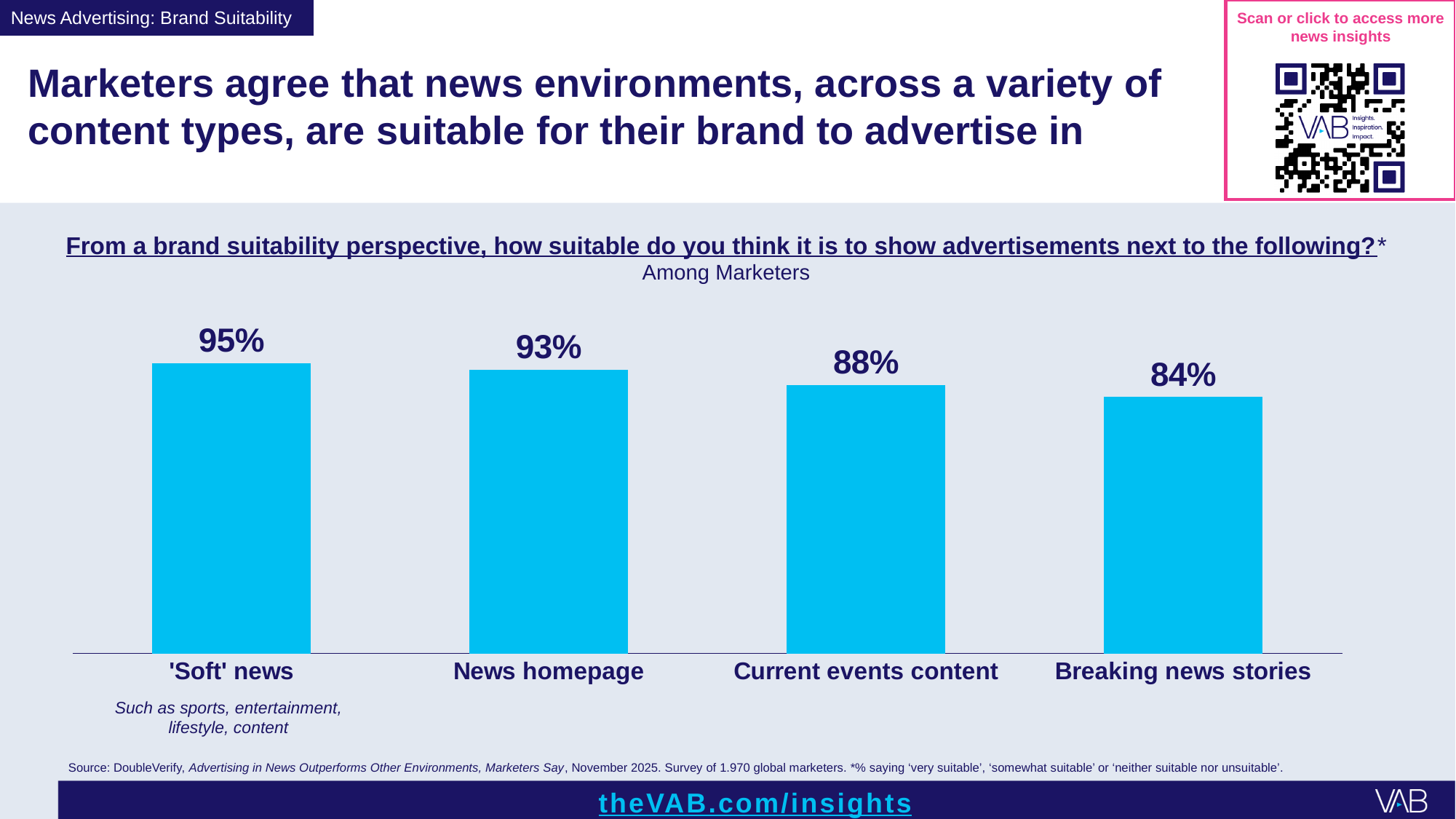
What is the difference in percentage points between News homepage and Current events content? 5 Which content type has the highest suitability percentage? 'Soft' news What is the value shown for Current events content? 88% Which content type has the lowest suitability percentage? Breaking news stories Do the values rise or fall moving from left to right across the chart? Fall What kind of chart is shown on the slide? Bar chart What is the difference in percentage points between 'Soft' news and Breaking news stories? 11 What is the value shown for News homepage? 93% How many content types are shown in the chart? 4 What is the value shown for Breaking news stories? 84% What percentage of marketers consider 'Soft' news suitable for showing advertisements next to? 95% Which has a higher value, Current events content or Breaking news stories? Current events content